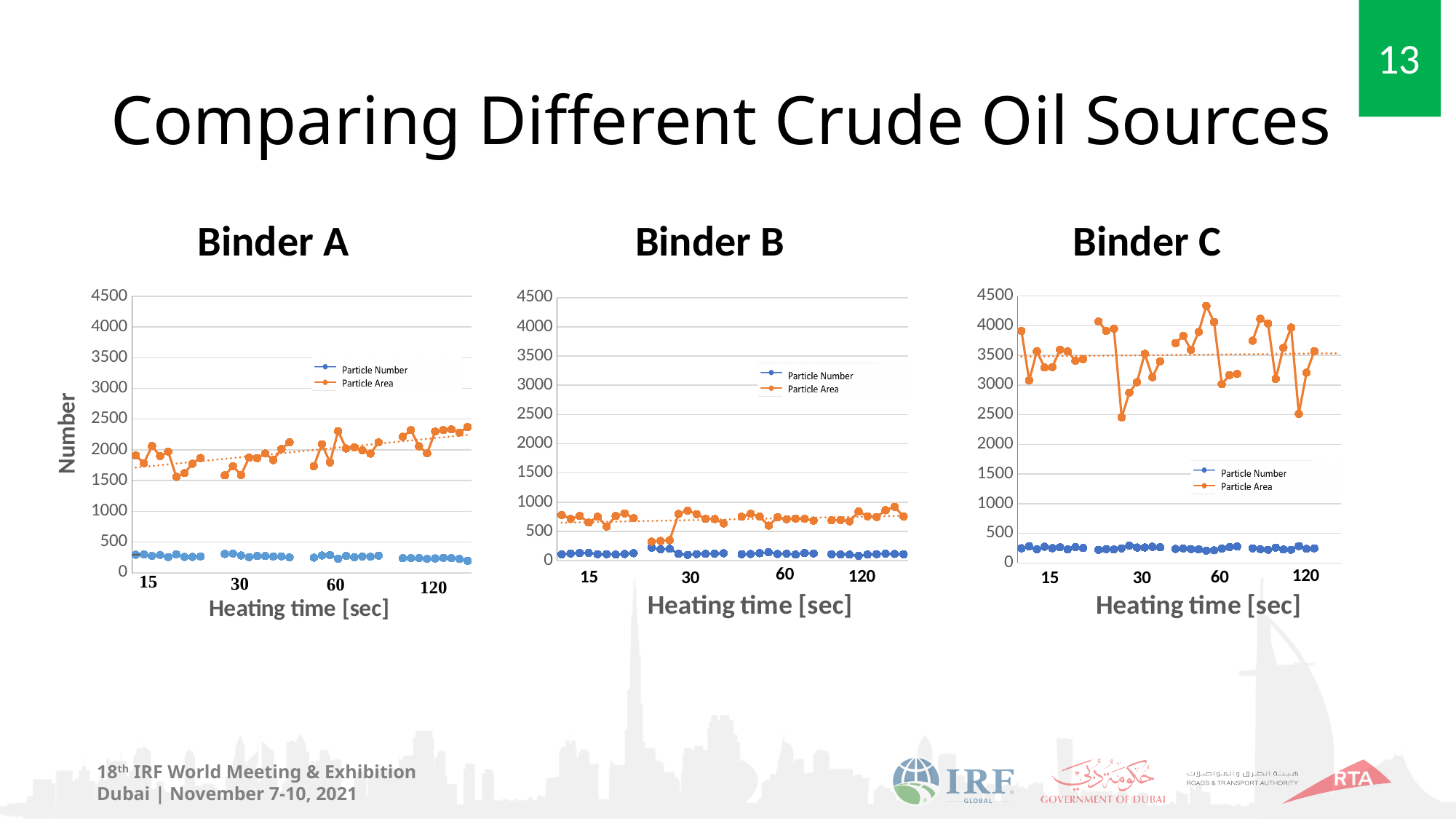
In the Binder C chart, are the Particle Area values greater or less than 2000? greater What is the x-axis title of the Binder A chart? Heating time [sec] How many charts are shown on the slide? 3 Which binder chart shows the lowest Particle Area values overall: Binder A, Binder B or Binder C? Binder B How many series does the legend of the Binder B chart list? 2 In the Binder A chart, does the Particle Area trend line rise or fall as heating time increases? rise In the Binder B chart, are the Particle Area values at the 120 sec mark greater or less than 1500? less What kind of chart is the Binder A chart? line chart In the Binder A chart, which series has the larger values, Particle Number or Particle Area? Particle Area In the Binder A chart, are the Particle Number values greater or less than 500? less What are the two series named in the legend of the Binder C chart? Particle Number and Particle Area Which binder chart shows the highest Particle Area values overall: Binder A, Binder B or Binder C? Binder C